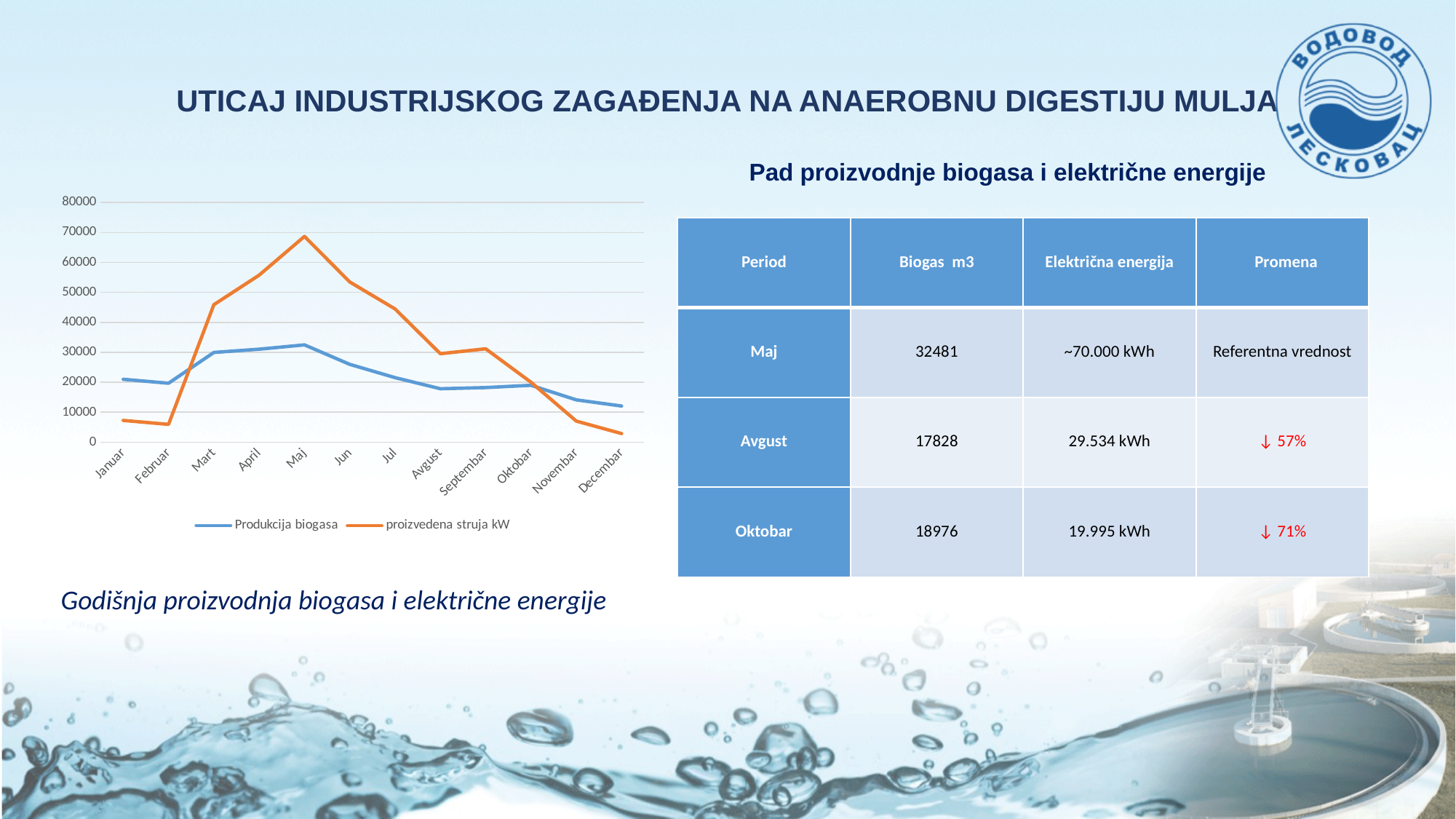
Does the 'proizvedena struja kW' series rise or fall from Maj to Decembar? Fall Is the value of 'Produkcija biogasa' in Januar greater or less than 30000? less How many series does the chart legend list? 2 In which month does the 'proizvedena struja kW' series reach its highest value? Maj In which month is the 'Produkcija biogasa' series at its lowest value? Decembar Is the value of 'proizvedena struja kW' in Februar greater or less than 10000? less In which month is the 'proizvedena struja kW' series at its lowest value? Decembar In Maj, which series has the larger value: 'Produkcija biogasa' or 'proizvedena struja kW'? proizvedena struja kW What kind of chart is shown on the slide? Line chart Is the value of 'proizvedena struja kW' in Maj greater or less than 60000? greater How many months are plotted along the x axis of the chart? 12 In Januar, which series has the larger value: 'Produkcija biogasa' or 'proizvedena struja kW'? Produkcija biogasa